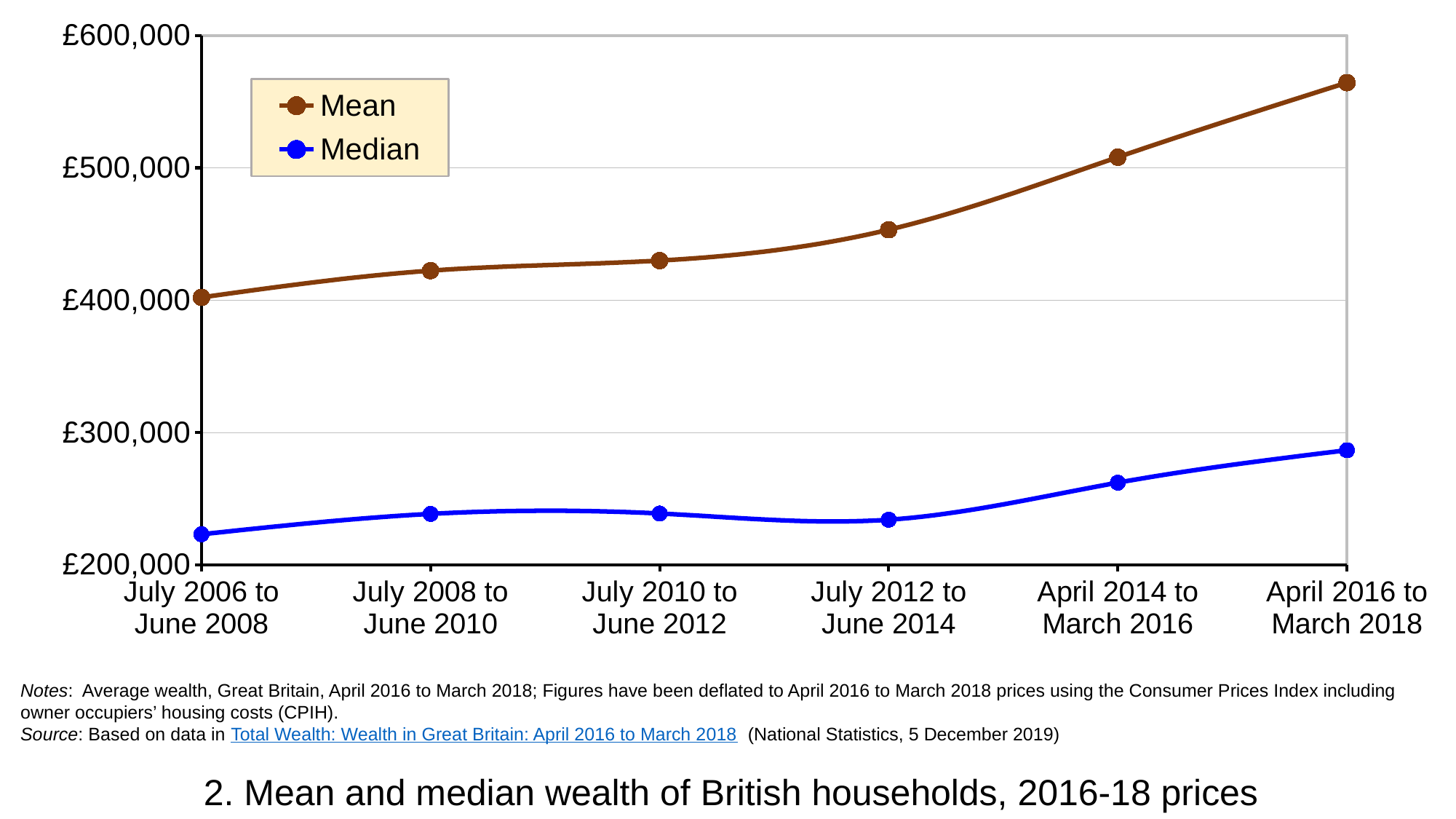
Is the Median value for April 2016 to March 2018 greater or less than £300,000? less How many series does the legend list? 2 In which period is the Mean series at its highest? April 2016 to March 2018 In which period is the Mean series at its lowest? July 2006 to June 2008 What colour is the line for the Median series? Blue What kind of chart is shown on the slide? Line chart Is the Mean value for April 2016 to March 2018 greater or less than £500,000? greater Does the Mean series rise or fall from July 2006 to June 2008 through April 2016 to March 2018? Rise Is the Mean value for July 2012 to June 2014 greater or less than £500,000? less How many time periods are plotted along the x axis? 6 Which is larger in July 2010 to June 2012, the Mean or the Median? Mean In which period is the Median series at its highest? April 2016 to March 2018